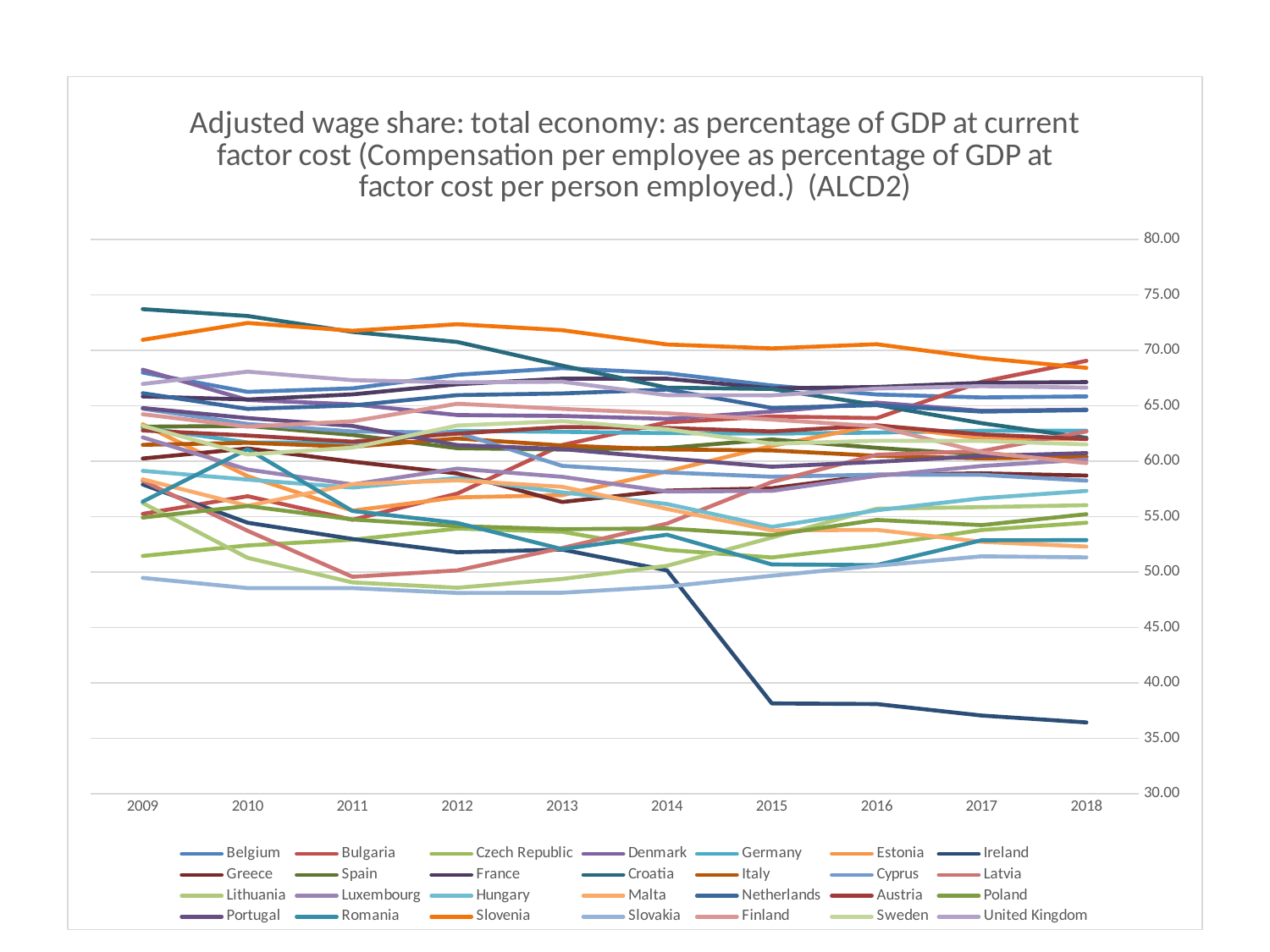
What kind of chart is shown on the slide? line chart Is the value for Ireland in 2015 greater or less than 40? less Which series has the highest value in 2009? Croatia Is the value for Ireland in 2018 greater or less than 40? less Which series has the lowest value in 2018? Ireland Is the value for Croatia in 2009 greater or less than 70? greater Which year is the first on the x axis? 2009 Does the line for Ireland rise or fall between 2009 and 2018? fall How many series does the legend list? 28 How many years are plotted along the x axis? 10